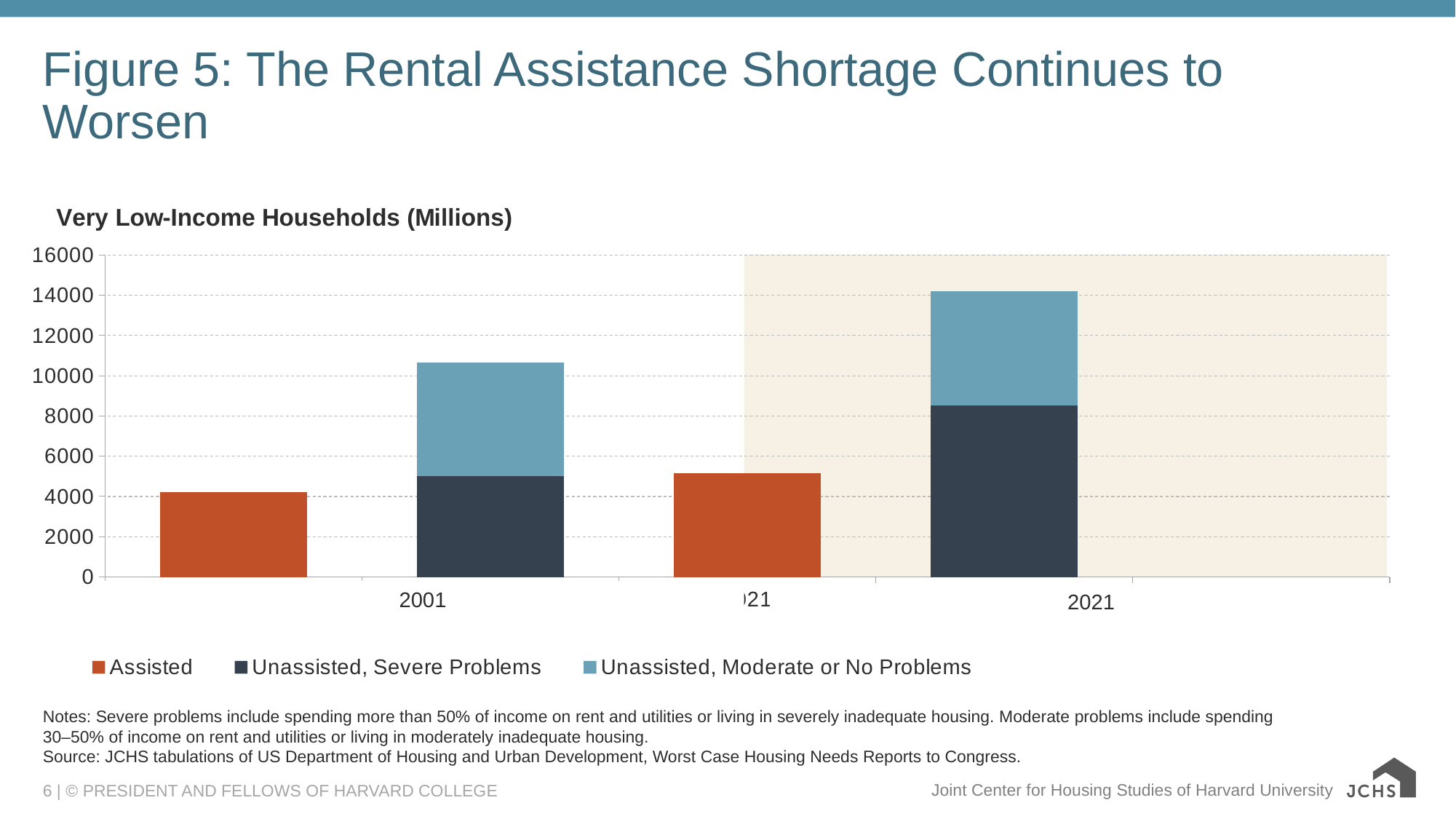
Is the top of the stacked unassisted bar for 2001 greater or less than 10000? greater How many series does the legend list? 3 Which year has the larger Assisted value, 2001 or 2021? 2021 Is the top of the stacked unassisted bar for 2021 greater or less than 12000? greater Which year has the larger Unassisted, Severe Problems value, 2001 or 2021? 2021 What kind of chart is shown on the slide? Stacked bar chart Do the Assisted values rise or fall from 2001 to 2021? rise How many years are shown on the x axis? 2 Which year has the taller stacked unassisted bar, 2001 or 2021? 2021 Is the Assisted value for 2001 greater or less than 6000? less What is the axis title shown above the chart? Very Low-Income Households (Millions)